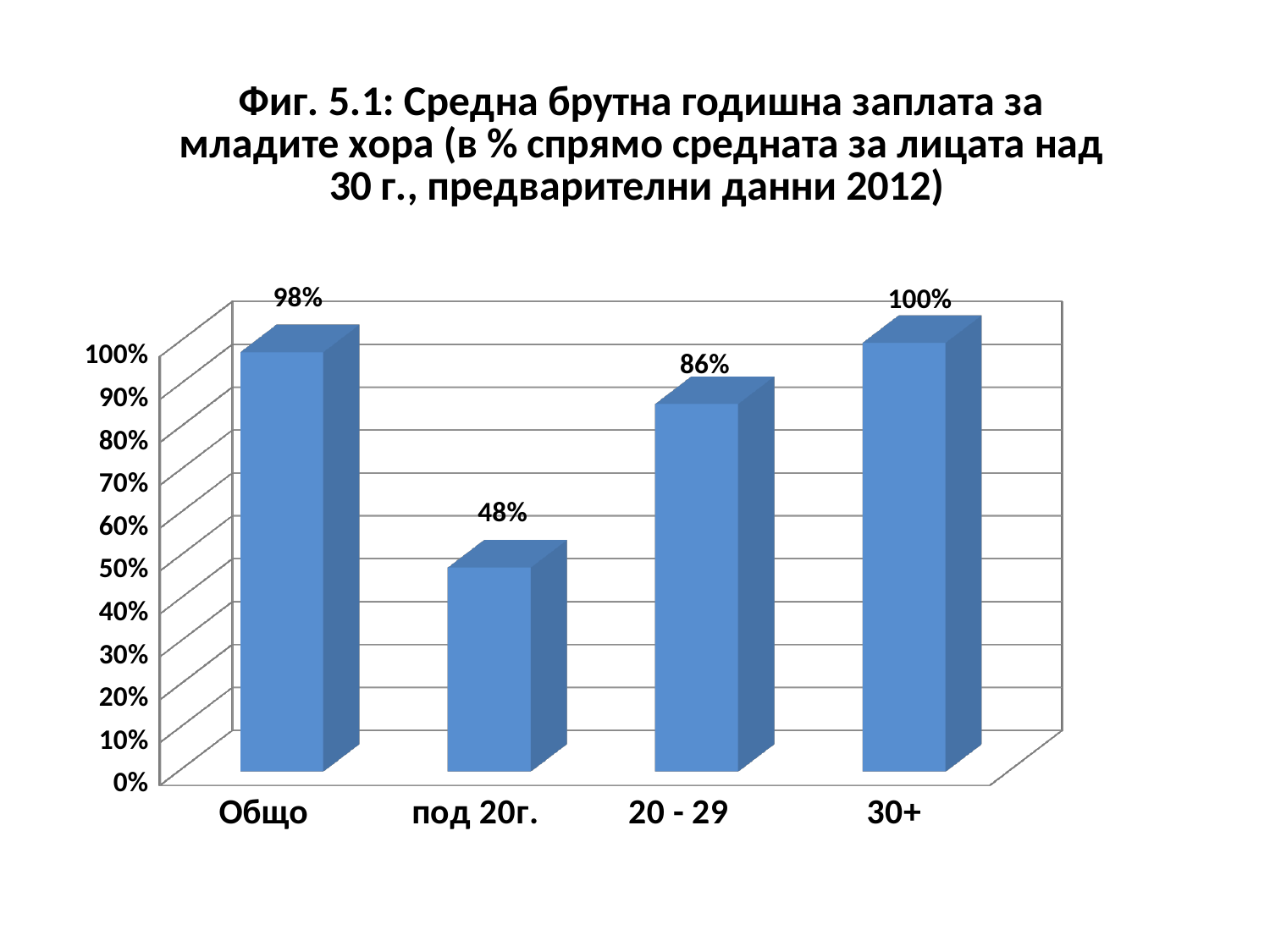
What is the value for the "Общо" category? 98% What is the figure number given in the chart title? Фиг. 5.1 What is the difference between the values for "30+" and "под 20г."? 52% What is the value for the "30+" category? 100% What is the value for the "под 20г." category? 48% What is the difference between the values for "Общо" and "20 - 29"? 12% What is the value for the "20 - 29" category? 86% What kind of chart is shown on the slide? bar chart How many categories are shown on the x axis? 4 Which category has the lowest value? под 20г. Which is larger, the value for "20 - 29" or the value for "под 20г."? 20 - 29 Which category has the highest value? 30+